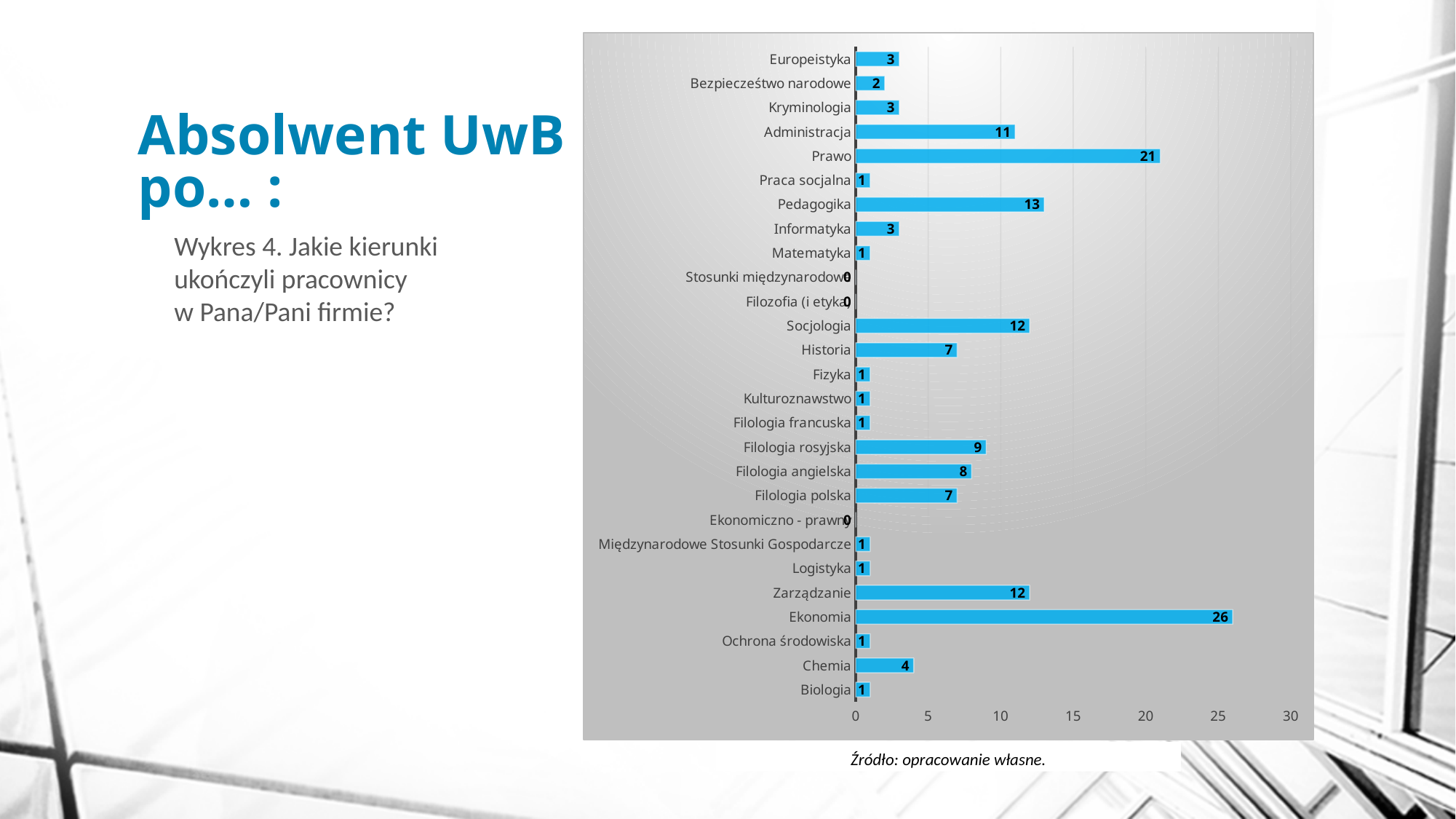
What value is shown for Pedagogika? 13 What is the caption of the chart on the slide? Wykres 4. Jakie kierunki ukończyli pracownicy w Pana/Pani firmie? What value is shown for Prawo? 21 What is the difference between the values for Ekonomia and Prawo? 5 What is the difference between the values for Socjologia and Historia? 5 What kind of chart is shown on the slide? Bar chart What value is shown for Filologia rosyjska? 9 Which category has the highest value? Ekonomia Which is larger, the value for Administracja or the value for Pedagogika? Pedagogika Which is larger, the value for Filologia angielska or the value for Chemia? Filologia angielska How many categories are shown on the chart? 27 What value is shown for Ekonomia? 26